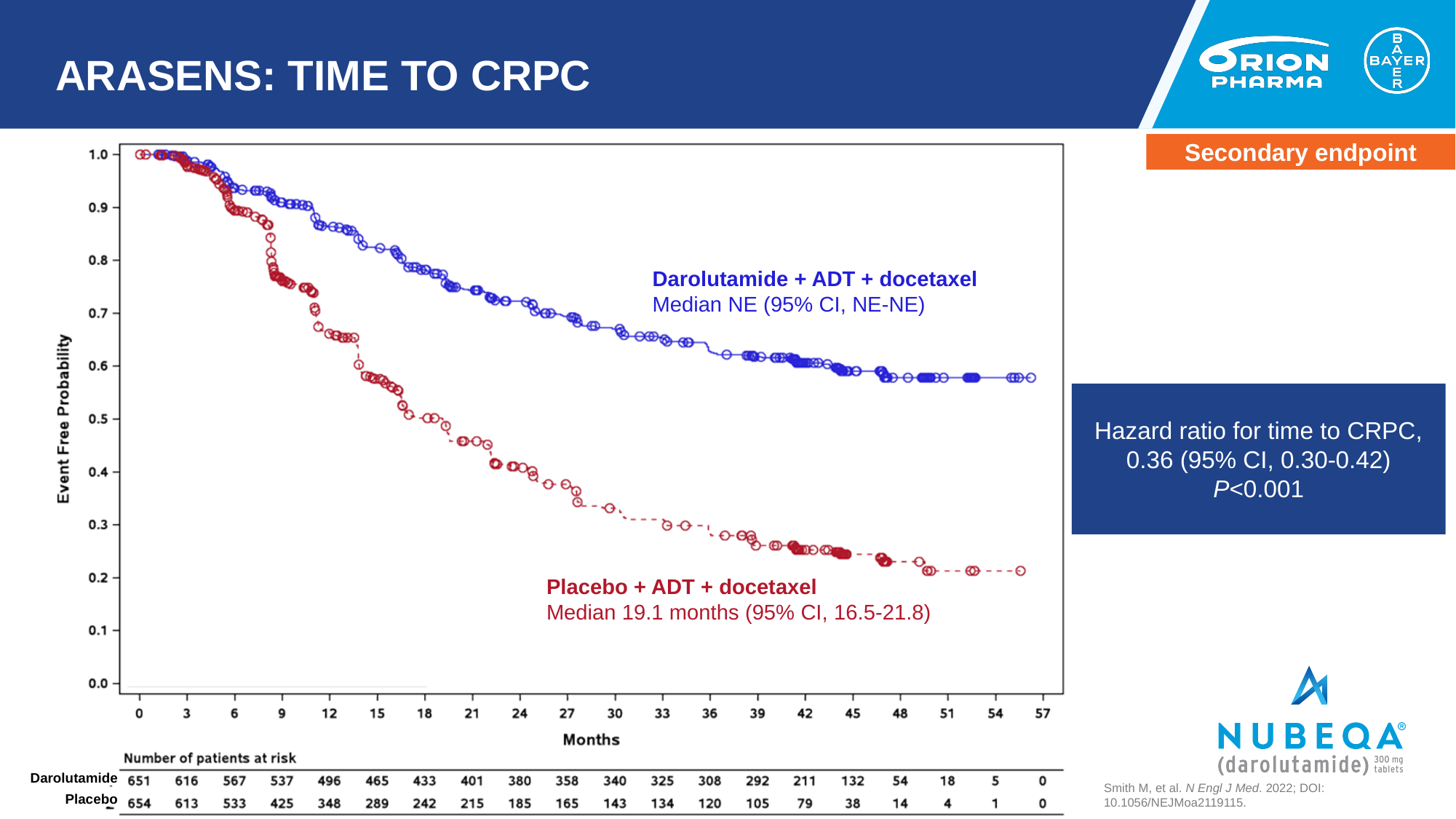
Is the event-free probability for the Placebo + ADT + docetaxel arm at 24 months greater or less than 0.5? less Which arm has the higher event-free probability at 36 months? Darolutamide + ADT + docetaxel How many treatment arms are plotted on the chart? 2 Do the event-free probability curves rise or fall as months increase? fall How many patients were at risk in the Placebo arm at 24 months? 185 What is the difference in the number of patients at risk between the Darolutamide and Placebo arms at 12 months? 148 What is the hazard ratio for time to CRPC shown on the slide? 0.36 Is the event-free probability for the Darolutamide + ADT + docetaxel arm at 48 months greater or less than 0.5? greater What is the median time to CRPC for the Darolutamide + ADT + docetaxel arm? NE How many patients were at risk in the Darolutamide arm at 0 months? 651 What is the label of the y axis? Event Free Probability What is the median time to CRPC for the Placebo + ADT + docetaxel arm? 19.1 months